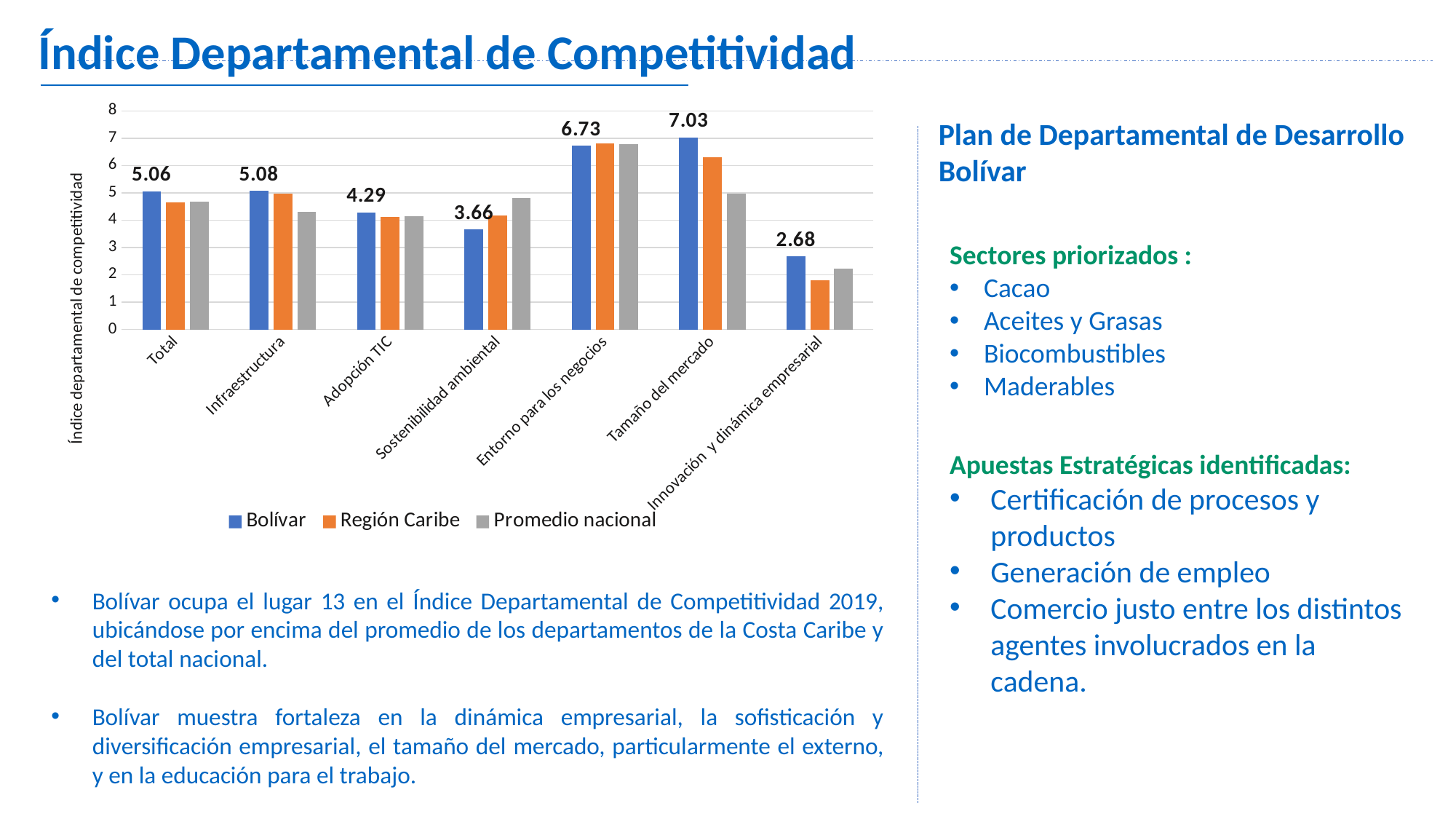
What is the value for Bolívar in the Total category? 5.06 What is the value for Bolívar in Adopción TIC? 4.29 Is the value for Promedio nacional in Sostenibilidad ambiental greater or less than 4? greater In which category does Bolívar have its highest value? Tamaño del mercado What is the difference between Bolívar's value in Tamaño del mercado and in Innovación y dinámica empresarial? 4.35 In Sostenibilidad ambiental, which is larger: Bolívar or Promedio nacional? Promedio nacional How many categories are shown on the x axis of the chart? 7 In Tamaño del mercado, which is larger: Bolívar or Promedio nacional? Bolívar In which category does Bolívar have its lowest value? Innovación y dinámica empresarial How many series does the chart legend list? 3 Is the value for Región Caribe in Innovación y dinámica empresarial greater or less than 2? less What is the value for Bolívar in Tamaño del mercado? 7.03